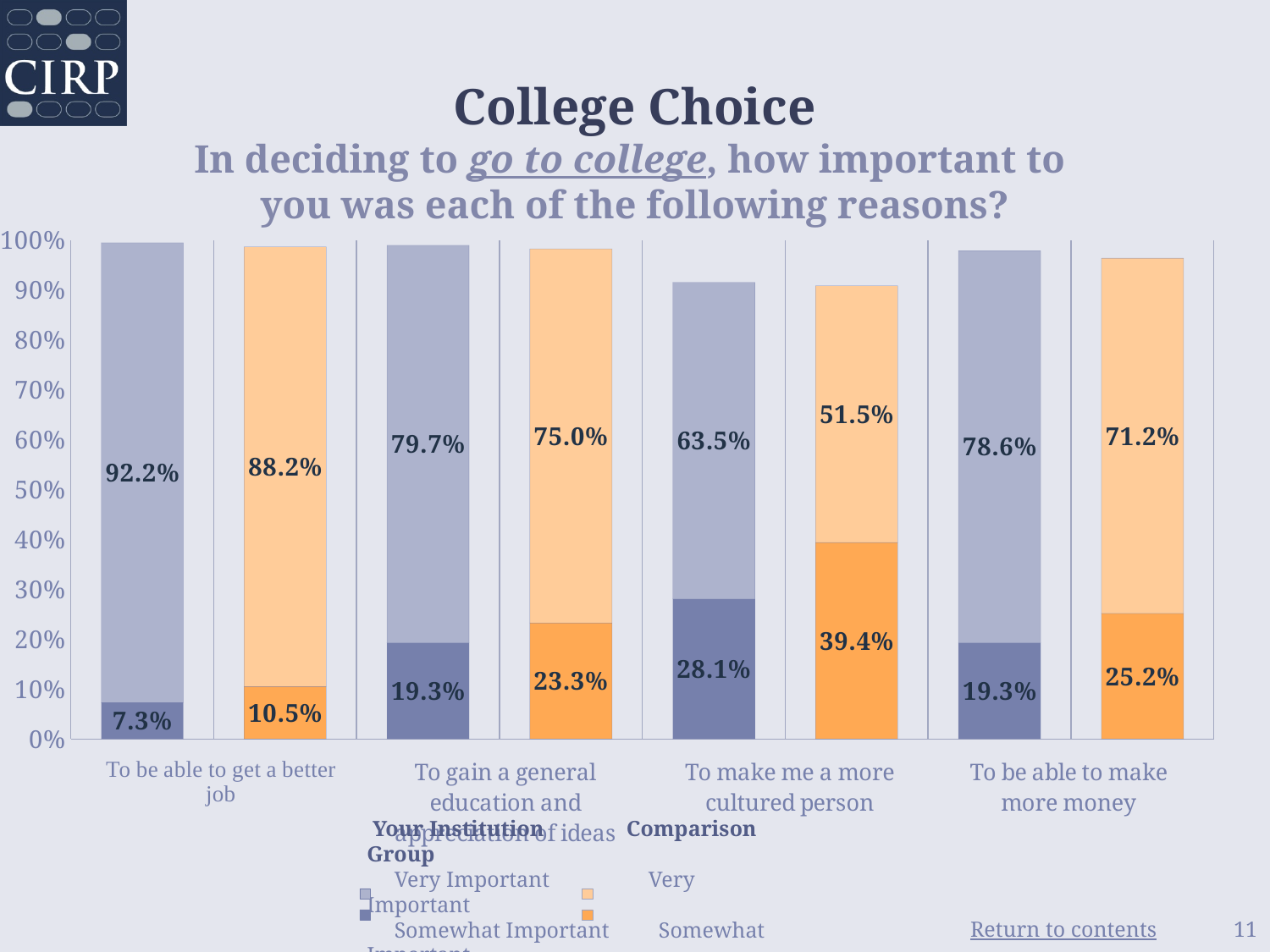
What is the combined Very Important and Somewhat Important total for Your Institution on "To be able to make more money"? 97.9% What is the Comparison Group's Very Important percentage for "To be able to make more money"? 71.2% How many series does the legend list? 4 What kind of chart is shown on the slide? Stacked bar chart What percentage of students at Your Institution rated "To be able to get a better job" as Very Important? 92.2% What is the title of the chart on the slide? College Choice How many reasons (categories) are shown on the x axis? 4 What is the difference between Your Institution's and the Comparison Group's Very Important percentages for "To make me a more cultured person"? 12.0% Which reason has the lowest Very Important percentage for the Comparison Group? To make me a more cultured person What percentage of the Comparison Group rated "To make me a more cultured person" as Somewhat Important? 39.4% Which reason has the highest Very Important percentage for Your Institution? To be able to get a better job For "To gain a general education and appreciation of ideas", which is larger: Your Institution's Very Important percentage or the Comparison Group's Very Important percentage? Your Institution